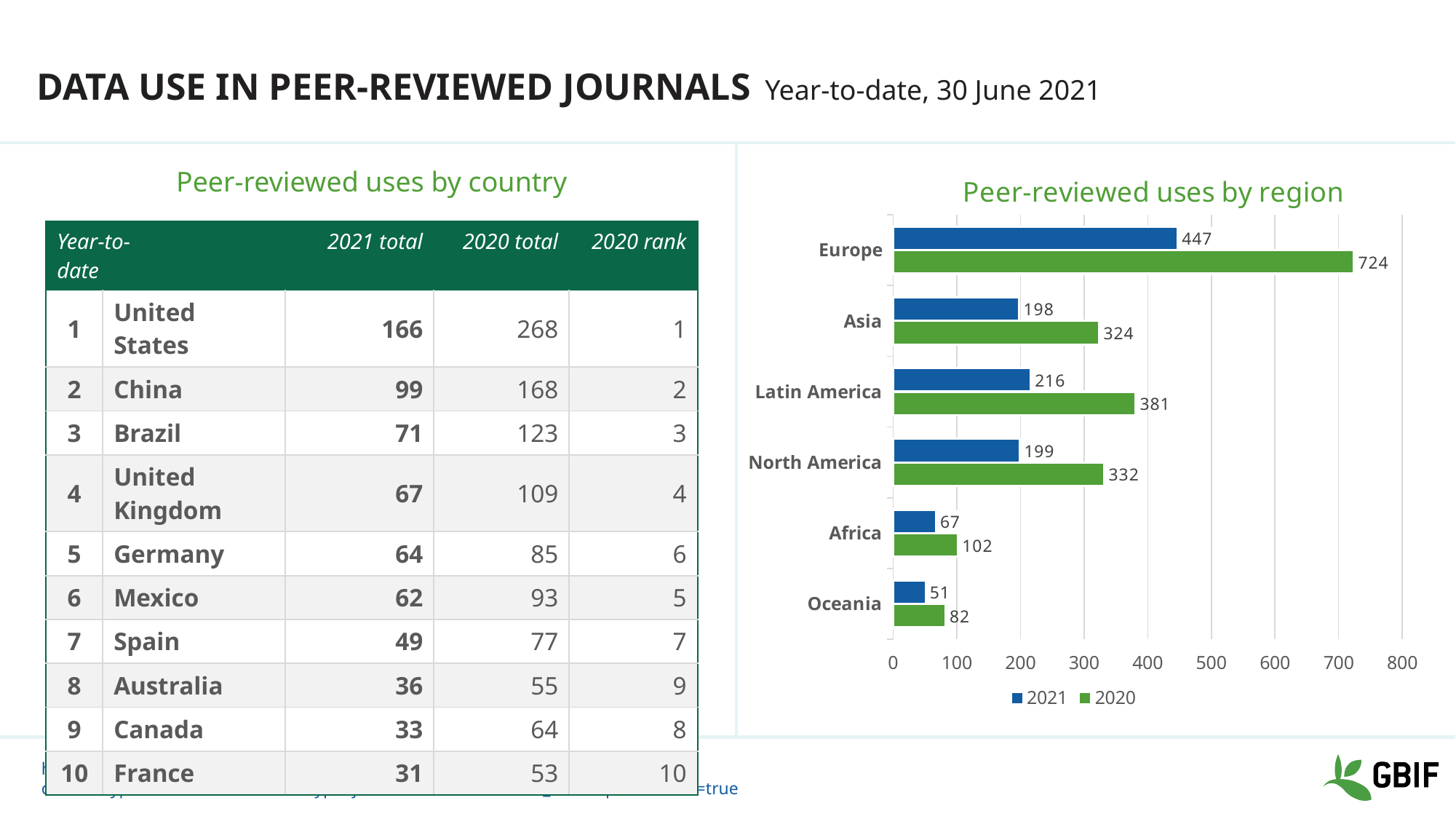
In the Peer-reviewed uses by region chart, what is the difference between the 2021 values for Latin America and Asia? 18 In the Peer-reviewed uses by region chart, which region has the highest 2020 value? Europe In the Peer-reviewed uses by region chart, what is the 2020 value for Oceania? 82 In the Peer-reviewed uses by region chart, what is the difference between the 2020 and 2021 values for Europe? 277 What kind of chart is the Peer-reviewed uses by region chart? Bar chart In the Peer-reviewed uses by region chart, what is the 2021 value for Europe? 447 In the Peer-reviewed uses by region chart, which is larger: the 2020 value for Asia or the 2020 value for North America? North America In the Peer-reviewed uses by region chart, is the 2020 value for Africa greater or less than 200? less How many regions are shown in the Peer-reviewed uses by region chart? 6 How many series does the legend of the Peer-reviewed uses by region chart list? 2 In the Peer-reviewed uses by region chart, what is the 2020 value for Latin America? 381 In the Peer-reviewed uses by region chart, which region has the lowest 2021 value? Oceania